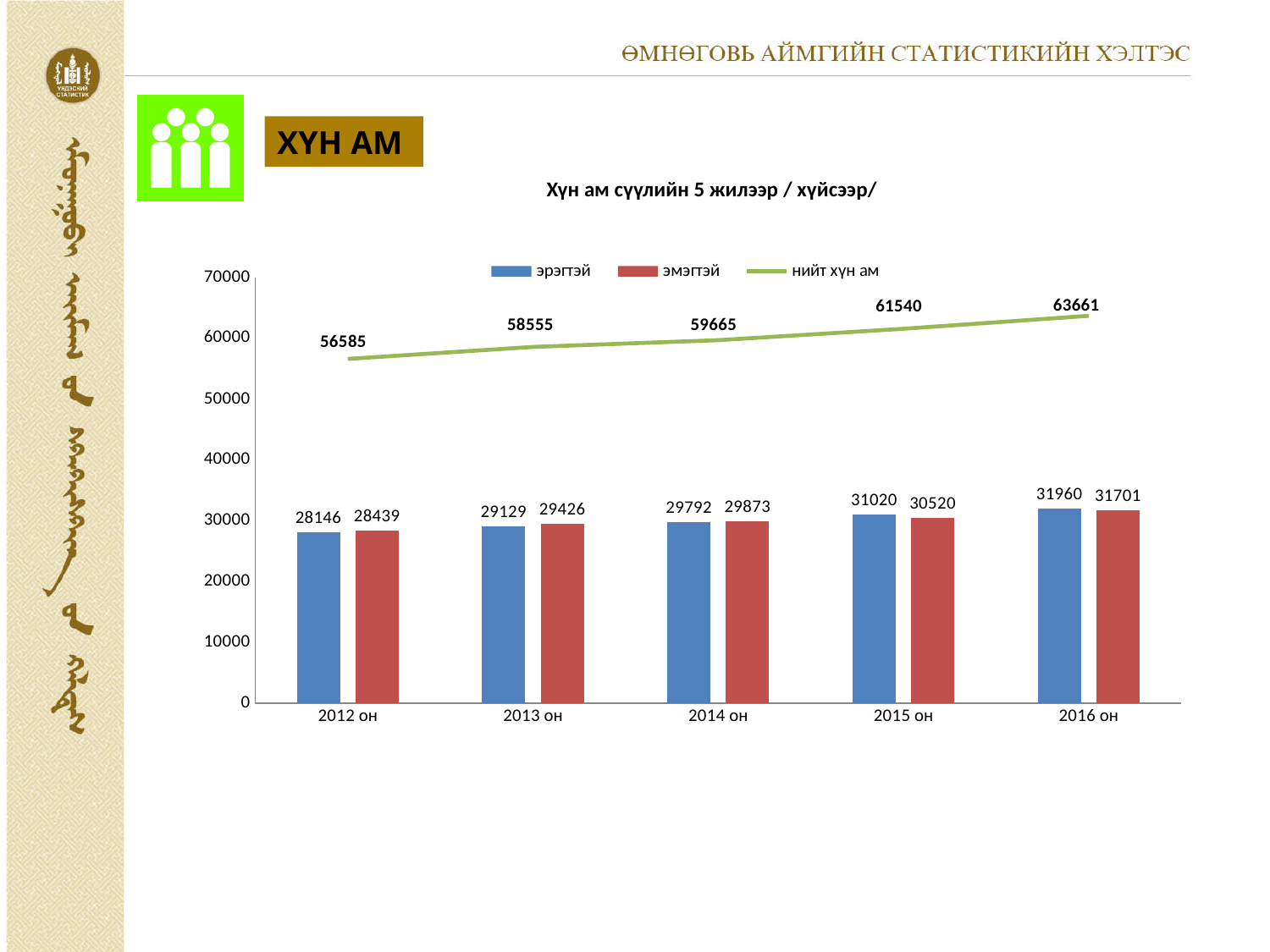
How many series does the legend list? 3 What is the value for эмэгтэй in 2015 он? 30520 In which year is нийт хүн ам highest? 2016 он What is the value of нийт хүн ам in 2016 он? 63661 Does нийт хүн ам rise or fall from 2012 он to 2016 он? rise What is the difference between нийт хүн ам in 2016 он and 2012 он? 7076 In which year is the эрэгтэй value lowest? 2012 он What is the title of the chart? Хүн ам сүүлийн 5 жилээр / хүйсээр/ How many years are shown on the x axis? 5 What is the value for эрэгтэй in 2012 он? 28146 What is the difference between эрэгтэй and эмэгтэй in 2015 он? 500 Which is larger in 2013 он, эрэгтэй or эмэгтэй? эмэгтэй